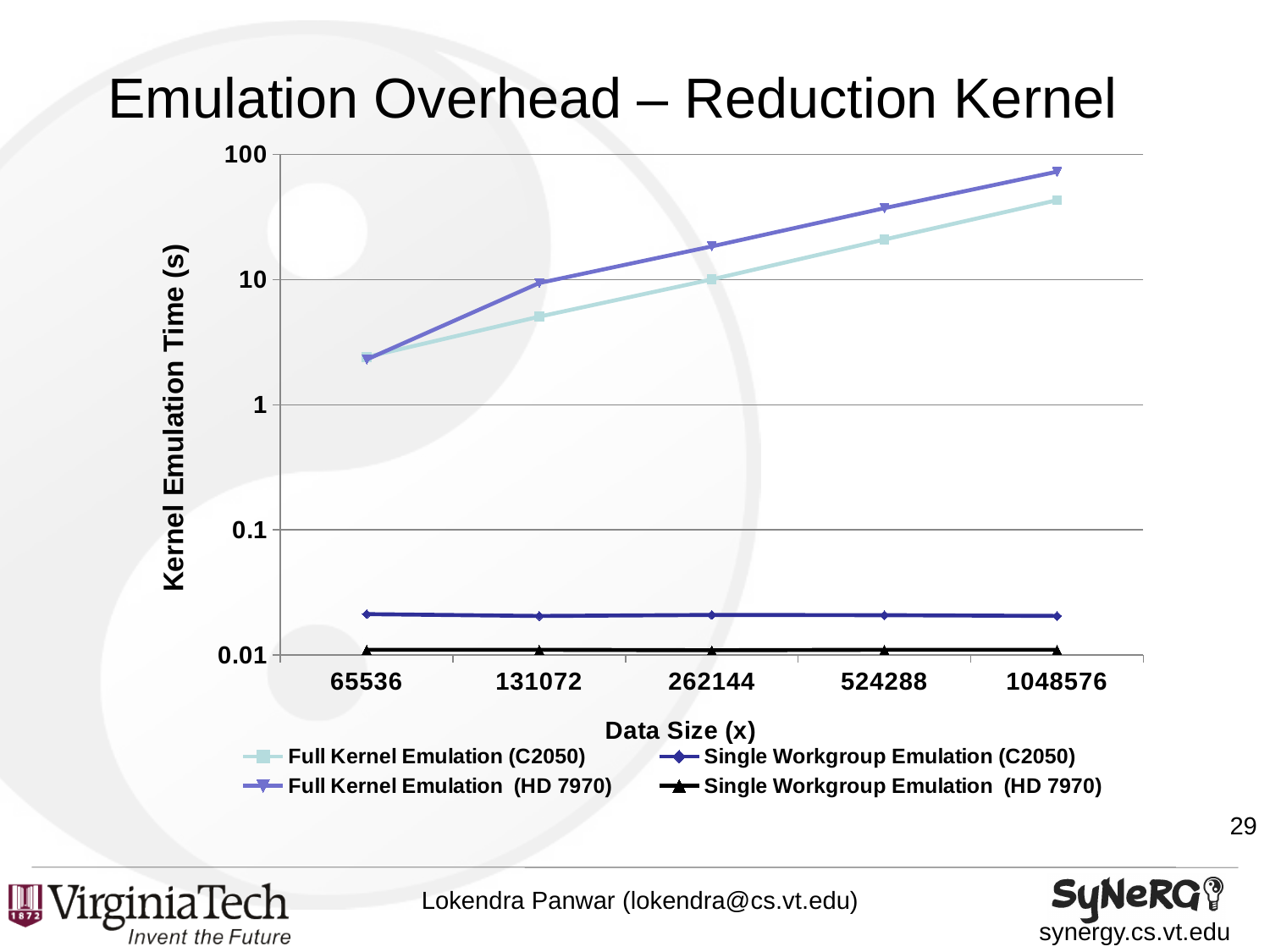
At data size 1048576, which is larger: Full Kernel Emulation (HD 7970) or Full Kernel Emulation (C2050)? Full Kernel Emulation (HD 7970) Is the value for Single Workgroup Emulation (C2050) at data size 262144 greater or less than 0.1? less What is the title of the chart? Emulation Overhead – Reduction Kernel What is the label of the y axis? Kernel Emulation Time (s) What kind of chart is shown on the slide? Line chart Which series has the highest value at data size 1048576? Full Kernel Emulation (HD 7970) How many data size categories are shown on the x axis? 5 Is the value for Full Kernel Emulation (HD 7970) at data size 1048576 greater or less than 10? greater How many series does the legend list? 4 Does the Full Kernel Emulation (C2050) series rise or fall as data size increases? Rises Is the value for Full Kernel Emulation (C2050) at data size 65536 greater or less than 1? greater Which series has the lowest values across all data sizes? Single Workgroup Emulation (HD 7970)